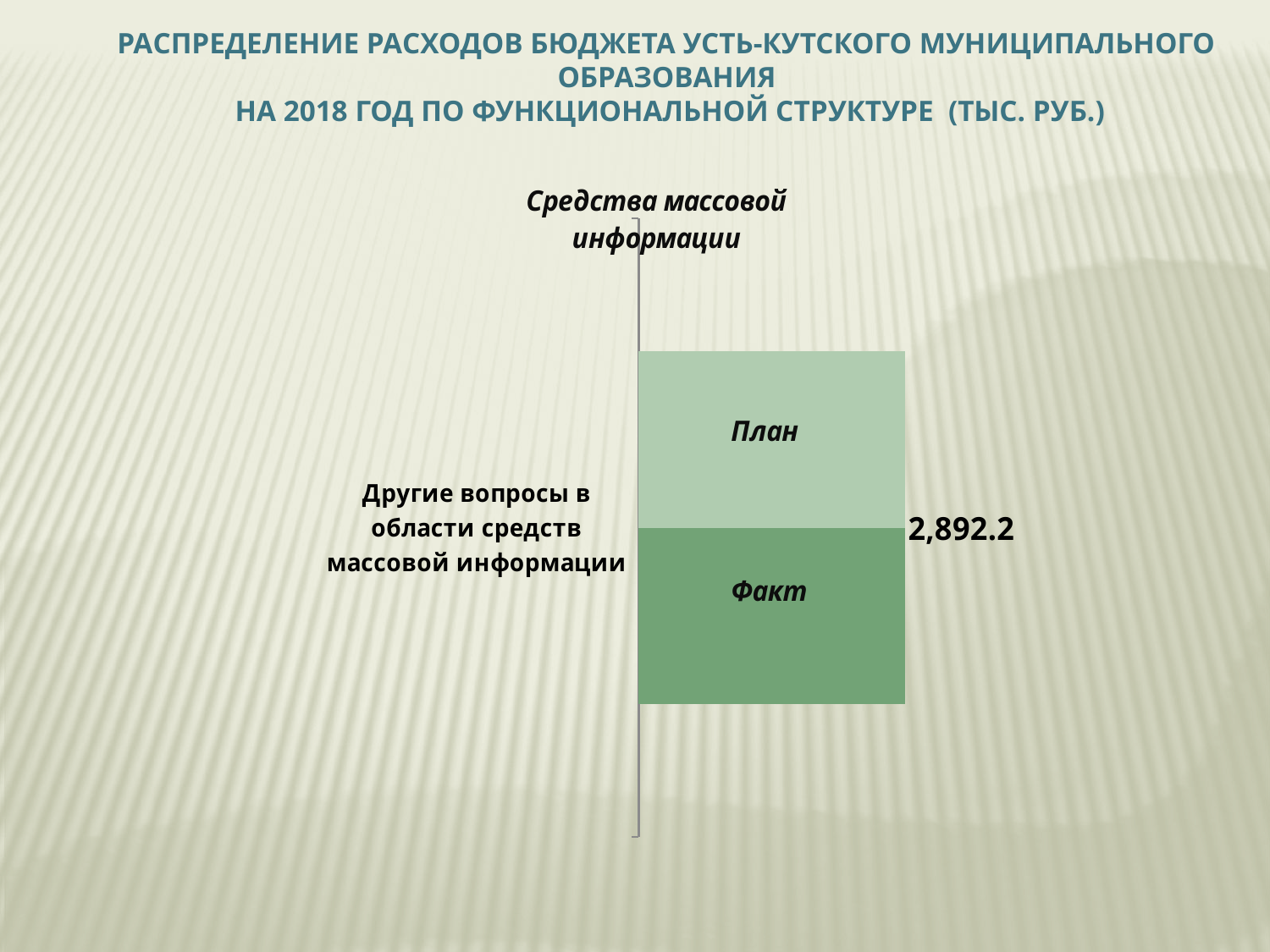
Which series bar is drawn above the other in the chart? План What value is printed as a data label on the chart? 2,892.2 How many categories are plotted in the chart? 1 What is the name of the category plotted in the chart? Другие вопросы в области средств массовой информации Are the bars in the chart horizontal or vertical? horizontal What kind of chart is shown on the slide? bar chart How many series are shown in the chart? 2